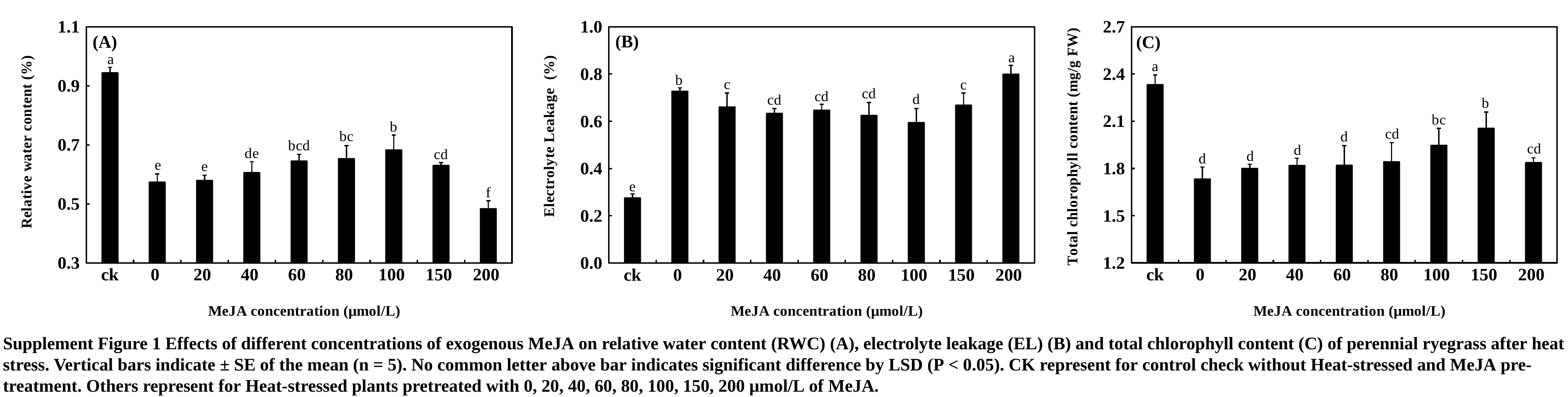
In chart (B), is the electrolyte leakage for 0 μmol/L larger or smaller than for 100 μmol/L? larger In chart (A), which MeJA concentration category has the lowest relative water content? 200 How many MeJA concentration categories are shown on the x axis of chart (C)? 9 In chart (A), which MeJA concentration category has the highest relative water content? ck In chart (B), which category has the lowest electrolyte leakage? ck In chart (B), which MeJA concentration category has the highest electrolyte leakage? 200 In chart (C), which category has the highest total chlorophyll content? ck In chart (A), is the relative water content for 200 μmol/L greater or less than 0.5? less In chart (C), is the total chlorophyll content for ck greater or less than 2.1? greater In chart (A), is the relative water content for ck greater or less than 0.9? greater What kind of chart is chart (B)? bar chart